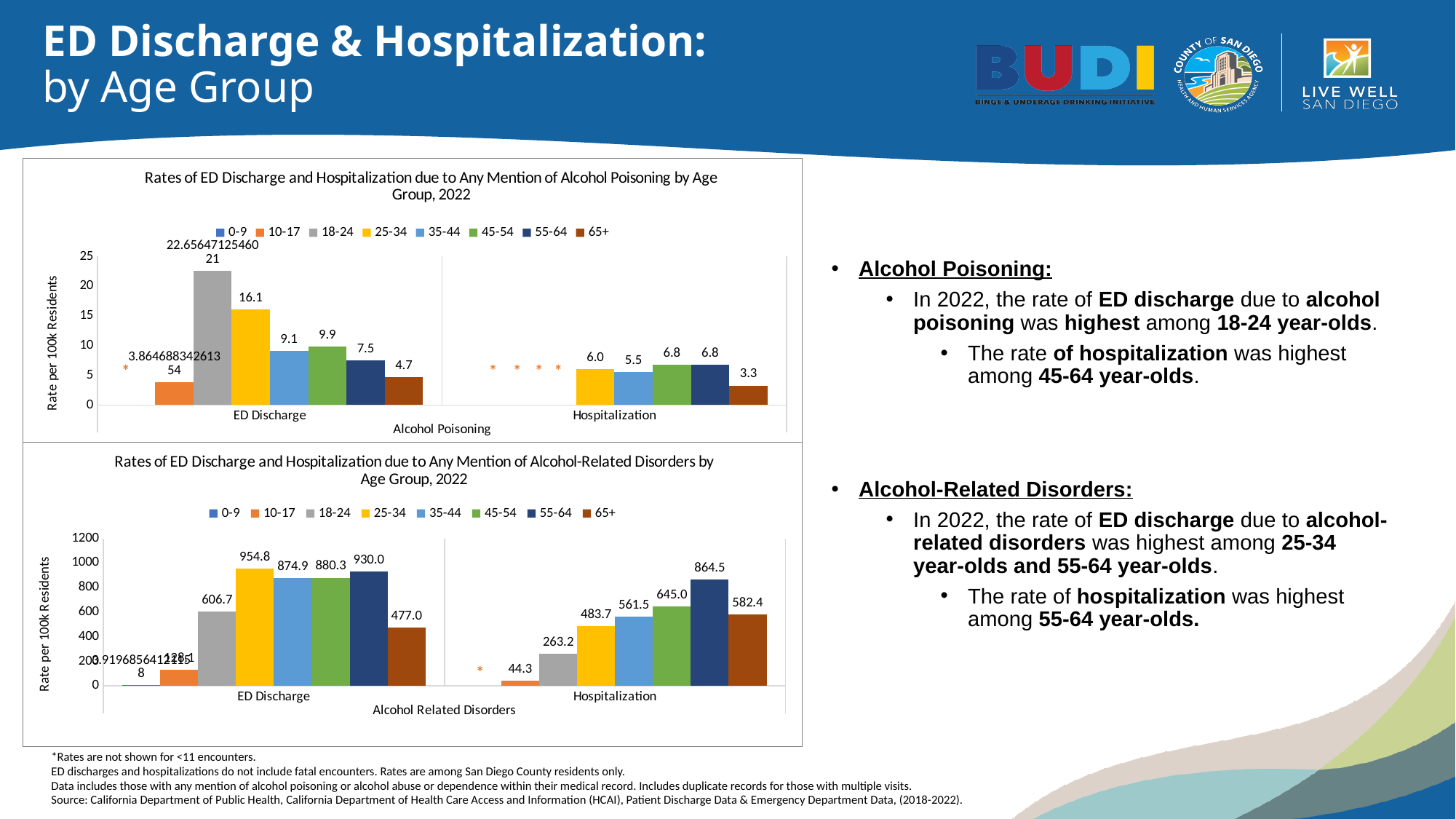
In the Alcohol-Related Disorders chart (bottom), what is the ED Discharge rate for the 25-34 age group? 954.8 In the Alcohol Poisoning chart (top), what is the difference between the ED Discharge rates for the 45-54 and 35-44 age groups? 0.8 In the Alcohol Poisoning chart (top), what is the Hospitalization rate for the 65+ age group? 3.3 In the Alcohol Poisoning chart (top), what is the ED Discharge rate for the 25-34 age group? 16.1 In the Alcohol-Related Disorders chart (bottom), which age group has the highest Hospitalization rate? 55-64 In the Alcohol-Related Disorders chart (bottom), which is larger: the ED Discharge rate for 18-24 or for 65+? 18-24 In the Alcohol-Related Disorders chart (bottom), what is the difference between the Hospitalization rates for the 45-54 and 35-44 age groups? 83.5 In the Alcohol-Related Disorders chart (bottom), what is the Hospitalization rate for the 55-64 age group? 864.5 How many series does the legend of the Alcohol Poisoning chart (top) list? 8 In the Alcohol Poisoning chart (top), which age group has the highest ED Discharge rate? 18-24 In the Alcohol Poisoning chart (top), is the ED Discharge rate for the 18-24 age group greater or less than 20? greater What type of chart is the Alcohol-Related Disorders chart (bottom)? Bar chart